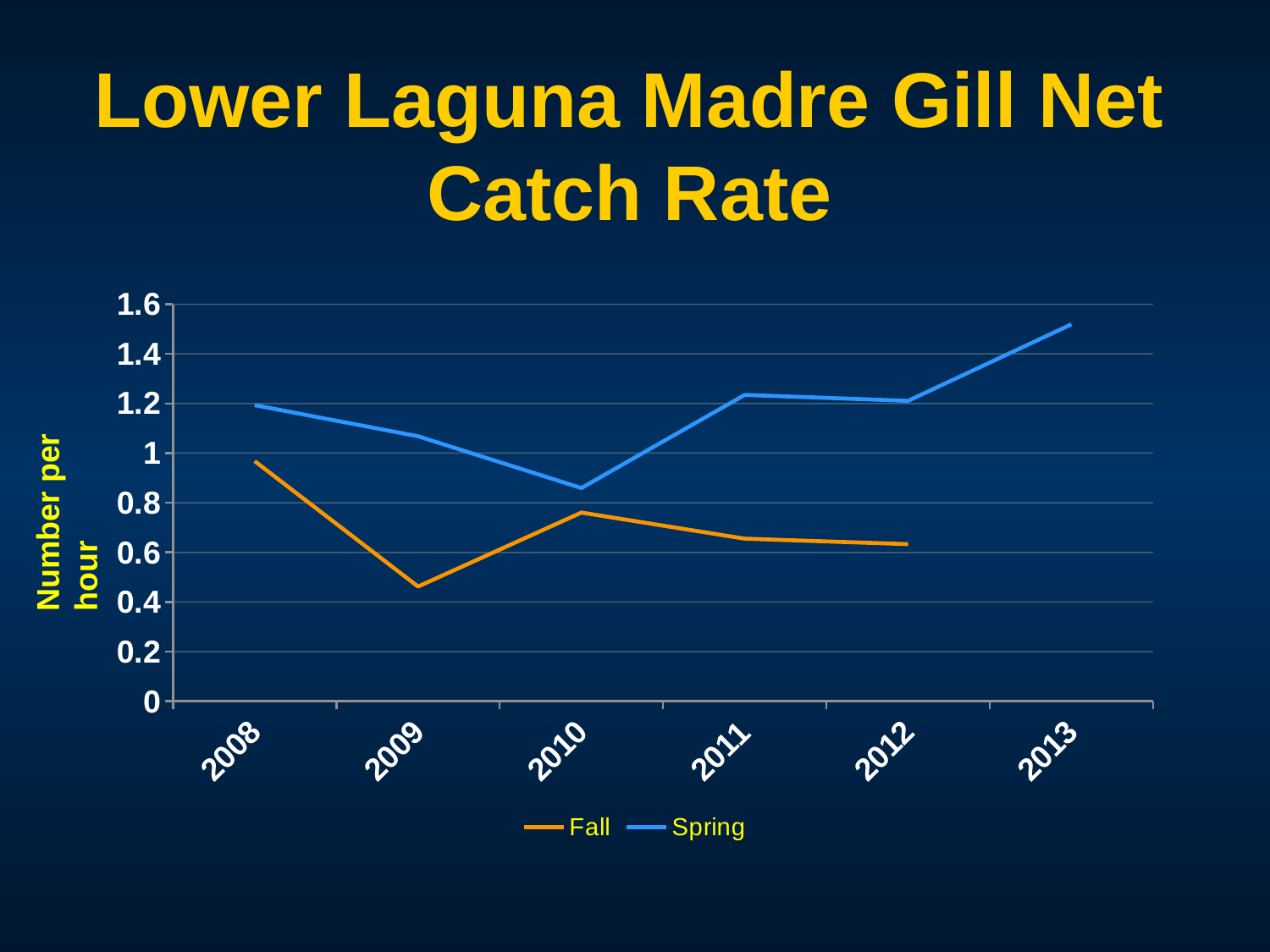
Which year has the highest Spring catch rate? 2013 Which year has the lowest Fall catch rate? 2009 Which series is higher in 2011, Fall or Spring? Spring Does the Spring catch rate rise or fall from 2010 to 2013? rise Which year has the lowest Spring catch rate? 2010 How many years are shown on the x axis? 6 What kind of chart is shown on the slide? line chart Is the Spring value for 2010 greater or less than 1? less How many series does the legend list? 2 What is the label on the y axis? Number per hour Is the Spring value for 2013 greater or less than 1.4? greater Is the Fall value for 2009 greater or less than 0.6? less